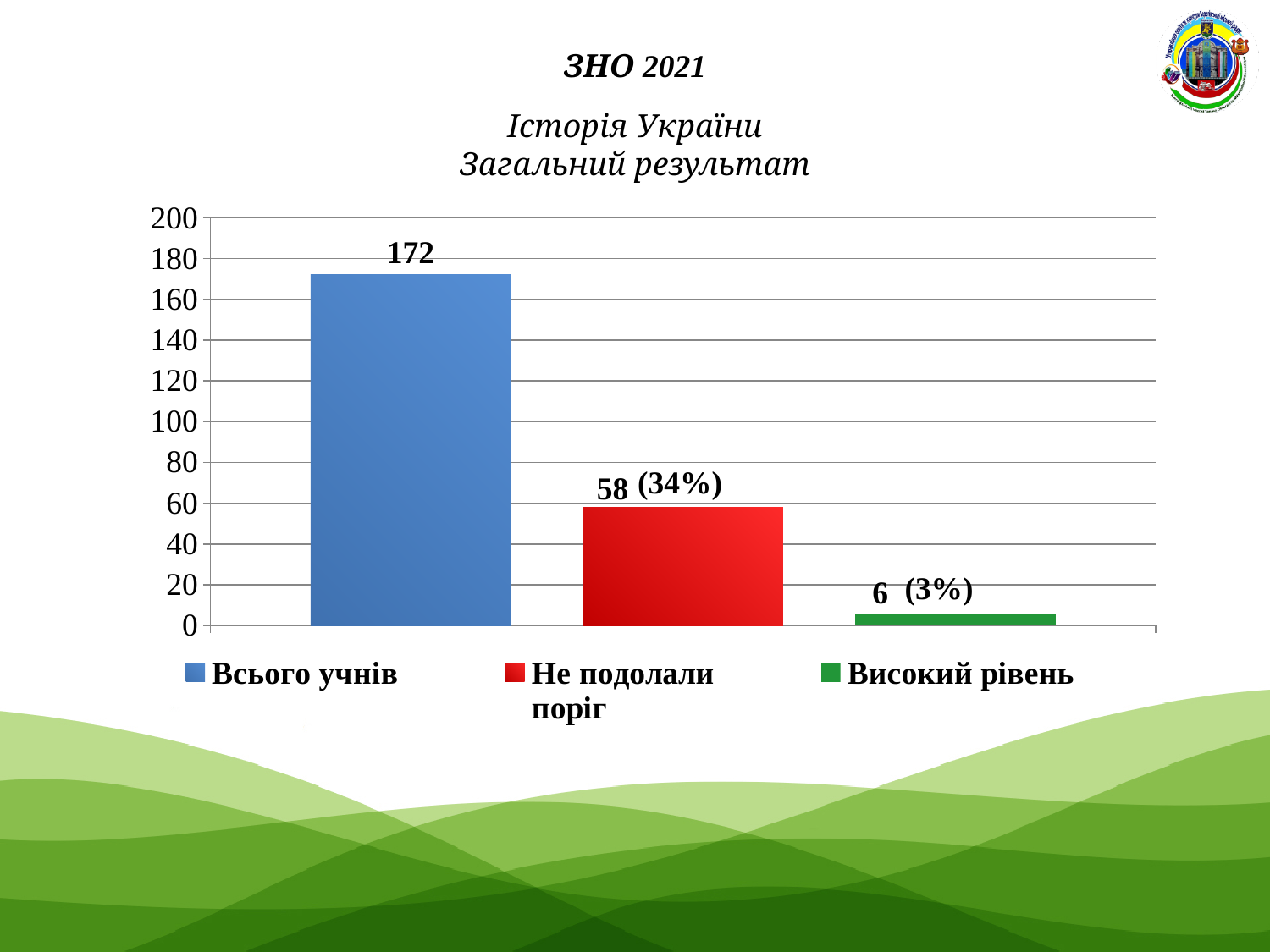
What is the value for Не подолали поріг? 58 How many entries does the legend list? 3 How many bars are plotted on the chart? 3 What is the value for Високий рівень? 6 Which is larger, the value for Не подолали поріг or the value for Високий рівень? Не подолали поріг Which category has the highest value? Всього учнів What is the value for Всього учнів? 172 What percentage is shown next to the Не подолали поріг bar? 34% What percentage is shown next to the Високий рівень bar? 3% Which category has the lowest value? Високий рівень What is the difference between the values for Всього учнів and Не подолали поріг? 114 What kind of chart is shown on the slide? Bar chart